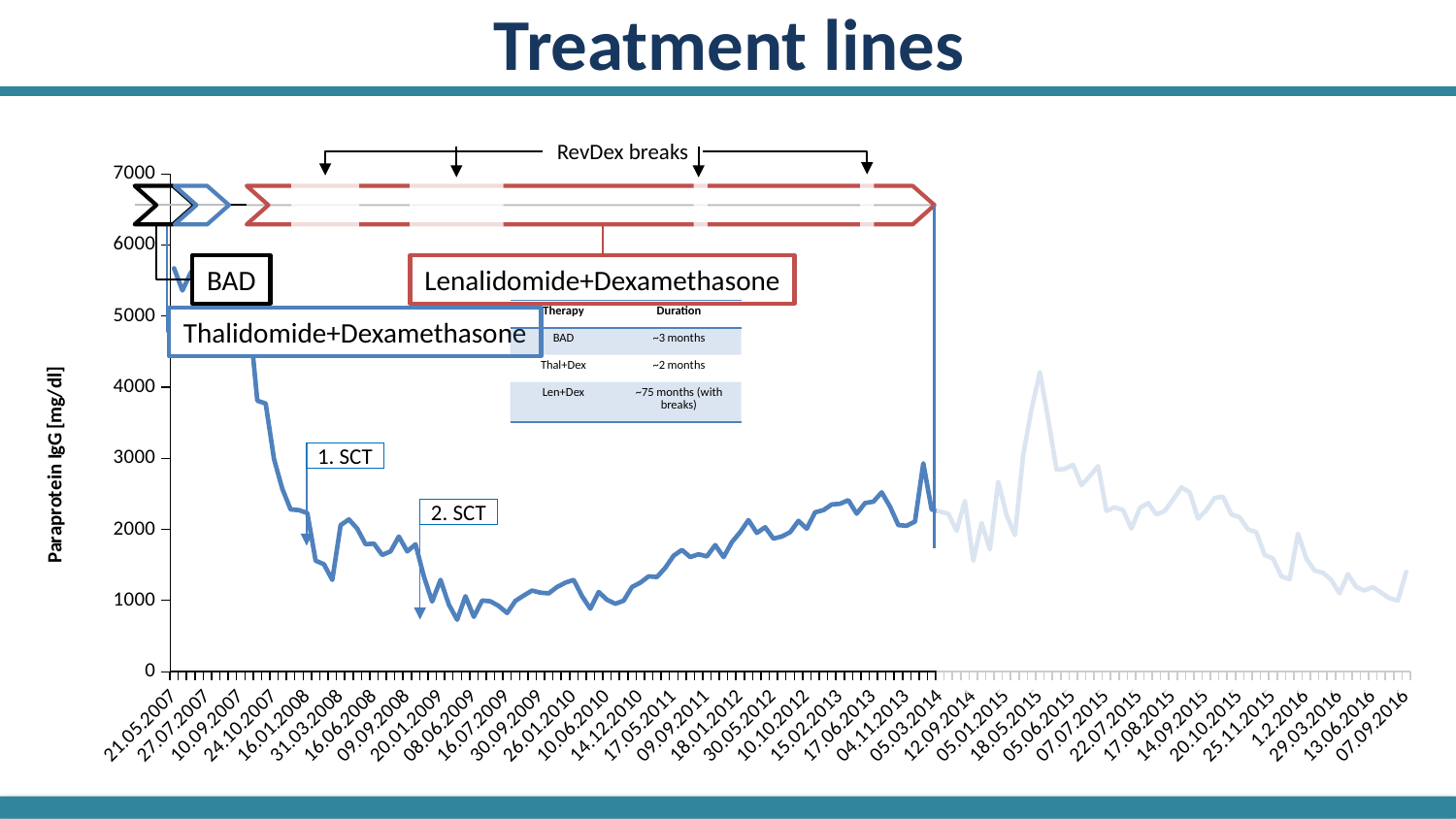
Do the values rise or fall between 10.06.2010 and 17.06.2013? rise Do the values rise or fall between 21.05.2007 and 08.06.2009? fall What is the label of the y axis? Paraprotein IgG [mg/dl] Is the value for 21.05.2007 greater or less than 5000? greater Is the value for 08.06.2009 greater or less than 1000? less Which of the two dates has the larger value, 17.06.2013 or 08.06.2009? 17.06.2013 Is the value for 07.09.2016 greater or less than 2000? less What is the highest value shown on the y axis? 7000 What kind of chart is shown on the slide? line chart Which of the two dates has the larger value, 05.06.2015 or 07.09.2016? 05.06.2015